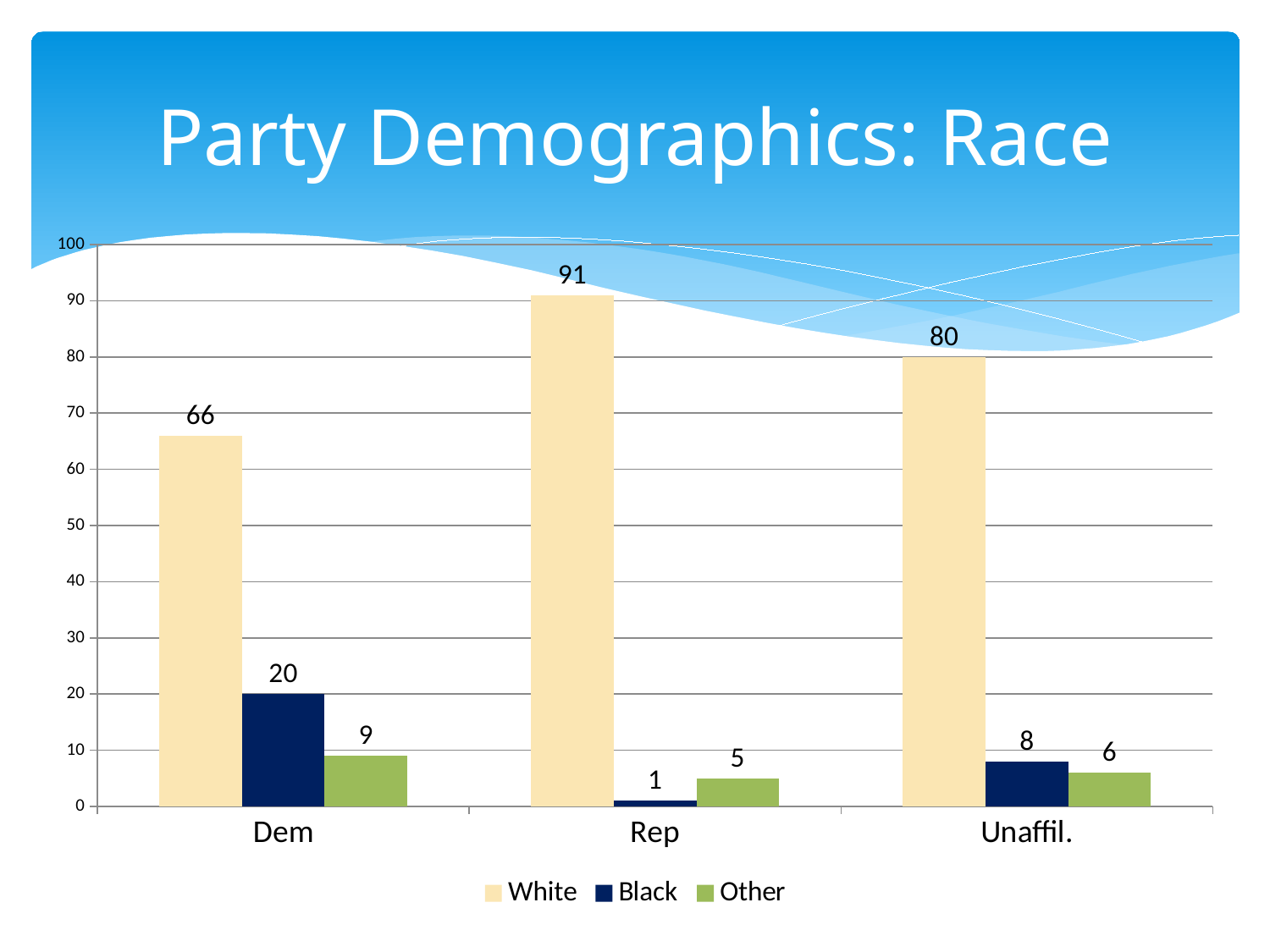
How many categories are shown on the x axis? 3 What is the difference between the White values for Rep and Dem? 25 What is the value for Black in the Rep category? 1 What is the value for Other in the Unaffil. category? 6 Is the value for White in the Unaffil. category greater or less than 70? greater Which is larger, the Black value for Dem or the Black value for Unaffil.? Dem How many series does the legend list? 3 What kind of chart is shown on the slide? bar chart What is the value for White in the Dem category? 66 Which category has the highest value for White? Rep What is the title of the slide? Party Demographics: Race Which category has the lowest value for Black? Rep